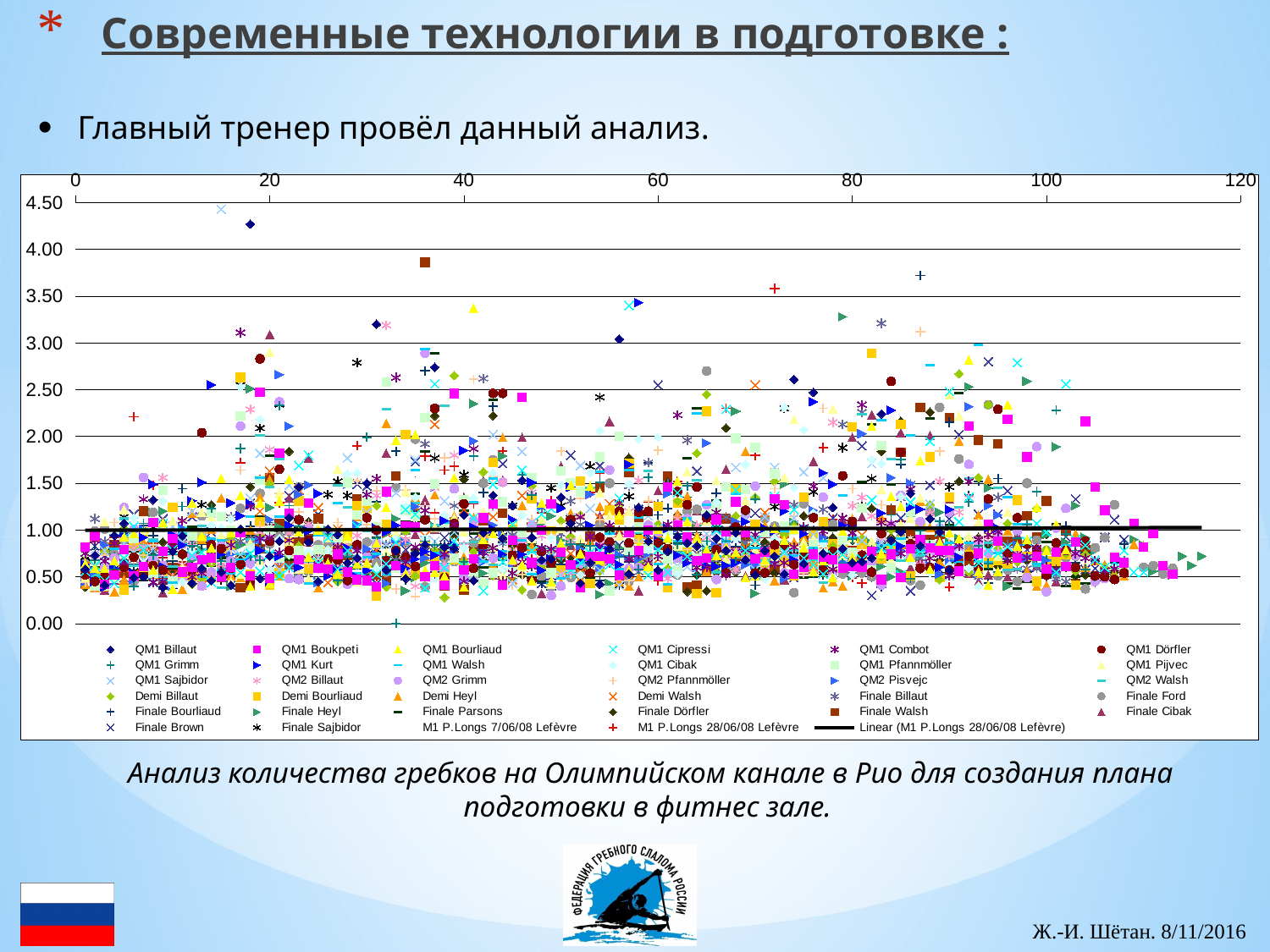
What is the highest value shown on the vertical axis of the chart? 4.50 Is the black horizontal trend line in the chart greater or less than 1.50 on the vertical axis? less What is the lowest value shown on the vertical axis of the chart? 0.00 How many entries does the chart legend list? 35 What is the step between consecutive labelled ticks on the horizontal axis of the chart? 20 Is the highest plotted point in the chart greater or less than 4.00 on the vertical axis? greater What kind of chart is shown on the slide? scatter chart Which legend entry does the solid black line in the chart represent? Linear (M1 P.Longs 28/06/08 Lefèvre) What is the highest value shown on the horizontal axis of the chart? 120 How many labelled tick values are there on the vertical axis of the chart? 10